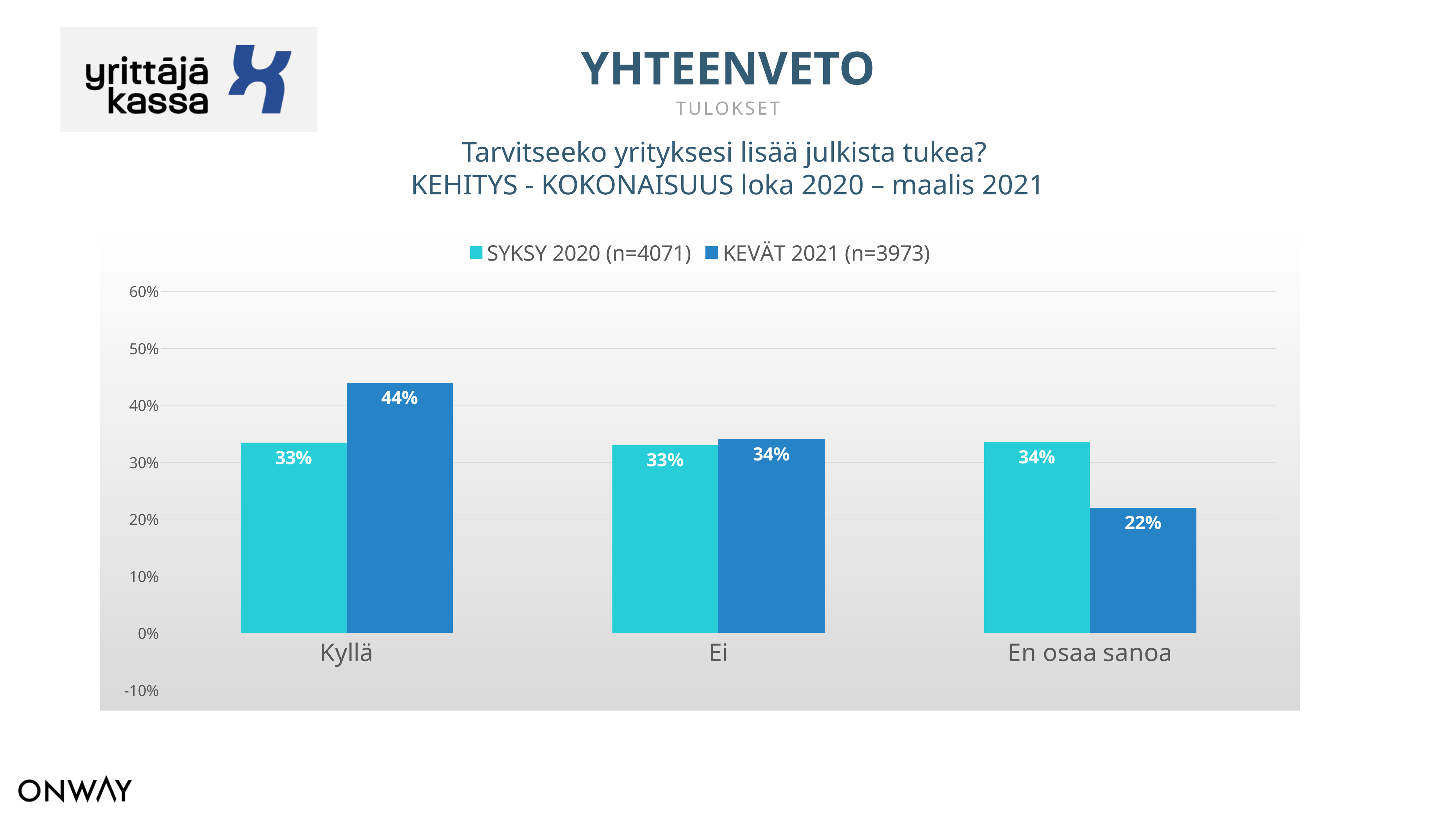
Which category has the lowest value in the KEVÄT 2021 (n=3973) series? En osaa sanoa What is the value for Kyllä in the KEVÄT 2021 (n=3973) series? 44% What is the value for Kyllä in the SYKSY 2020 (n=4071) series? 33% What kind of chart is shown on the slide? Bar chart What is the difference between the KEVÄT 2021 and SYKSY 2020 values for Kyllä? 11% How many categories are shown on the x axis? 3 What is the difference between the SYKSY 2020 and KEVÄT 2021 values for En osaa sanoa? 12% Which category has the highest value in the KEVÄT 2021 (n=3973) series? Kyllä For En osaa sanoa, which series has the larger value, SYKSY 2020 or KEVÄT 2021? SYKSY 2020 How many series does the legend list? 2 What is the value for Ei in the KEVÄT 2021 (n=3973) series? 34% What is the value for En osaa sanoa in the SYKSY 2020 (n=4071) series? 34%